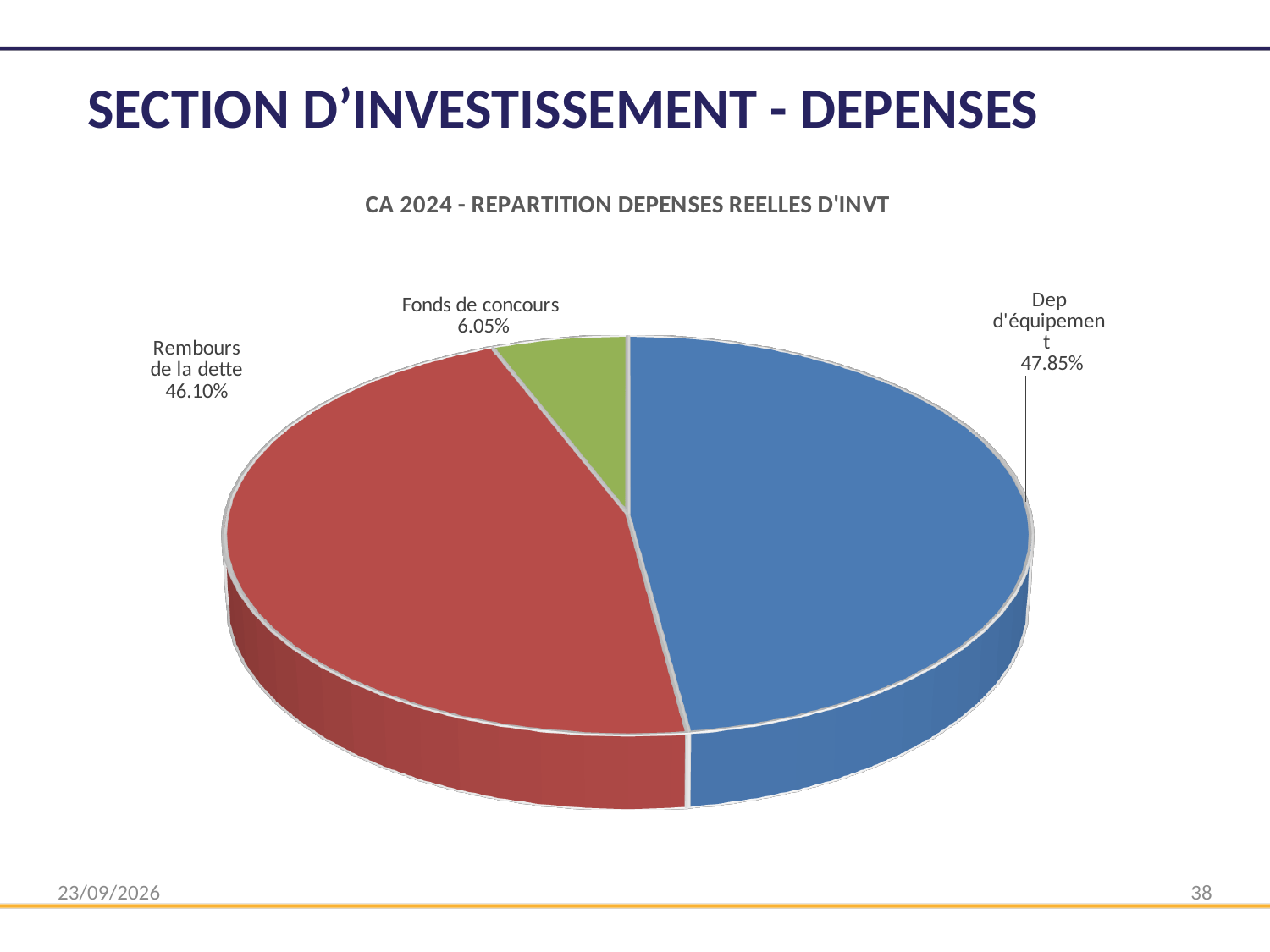
What is the difference in percentage points between Rembours de la dette and Fonds de concours? 40.05 Which category has the smallest share of the pie? Fonds de concours What colour is the slice for Fonds de concours? Green What is the title of the chart? CA 2024 - REPARTITION DEPENSES REELLES D'INVT What share of the pie does Fonds de concours represent? 6.05% What is the difference in percentage points between Dep d'équipement and Rembours de la dette? 1.75 Which is larger, the share for Rembours de la dette or the share for Fonds de concours? Rembours de la dette Which category has the largest share of the pie? Dep d'équipement What kind of chart is shown on the slide? Pie chart What share of the pie does Dep d'équipement represent? 47.85% How many categories are shown in the pie chart? 3 What share of the pie does Rembours de la dette represent? 46.10%